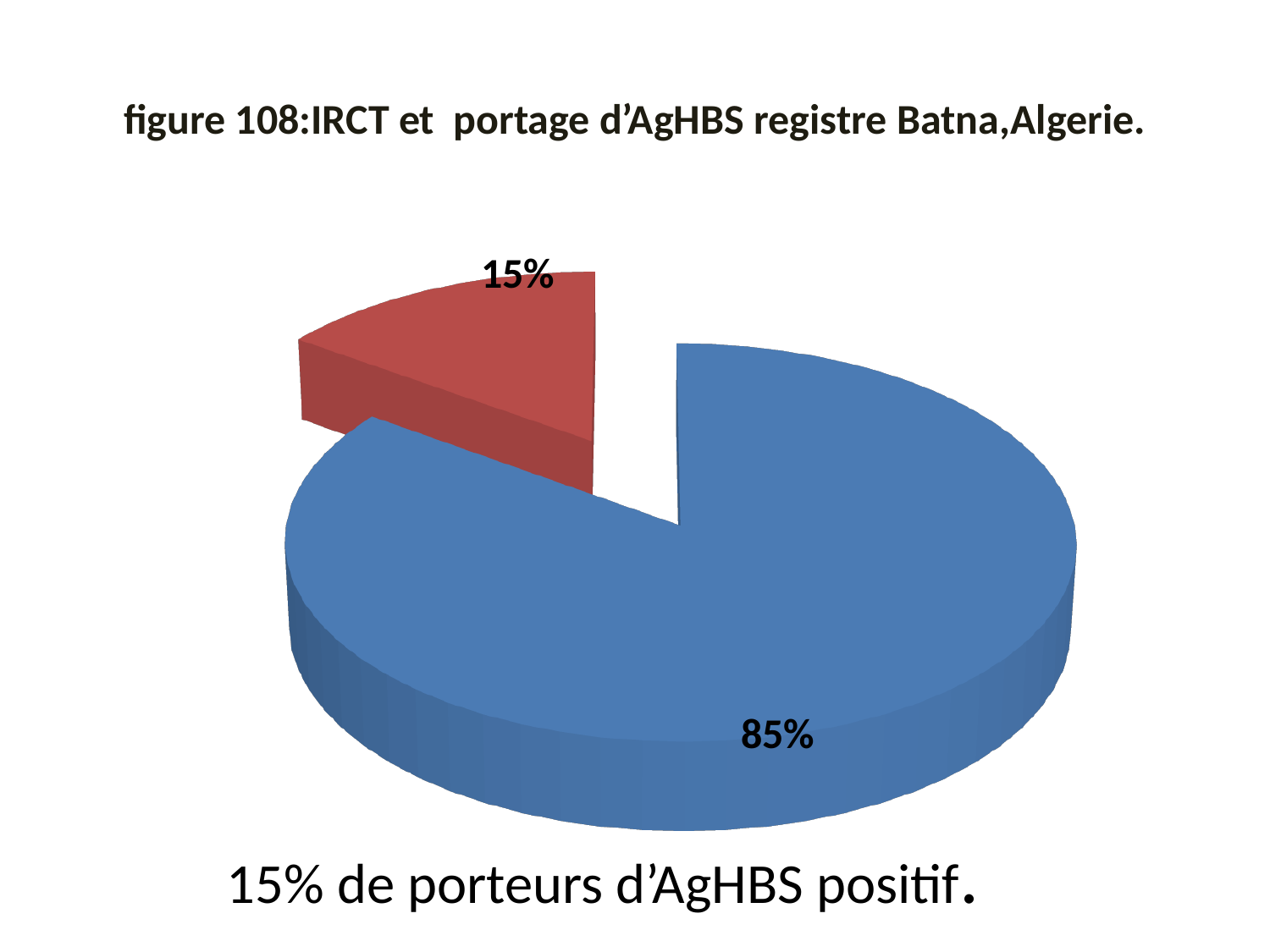
According to the slide, what share of patients are AgHBS positive carriers? 15% Which is larger, the red slice or the blue slice? The blue slice What is the difference in percentage points between the blue slice and the red slice? 70 What is the title of the chart? figure 108:IRCT et portage d'AgHBS registre Batna,Algerie. How many slices does the pie chart have? 2 Which slice of the pie chart is the largest? The blue slice (85%) What percentage is shown on the red slice of the pie chart? 15% What colour is the slice labelled 85%? Blue What percentage is shown on the blue slice of the pie chart? 85% Which slice of the pie chart is the smallest? The red slice (15%) What kind of chart is shown on the slide? Pie chart